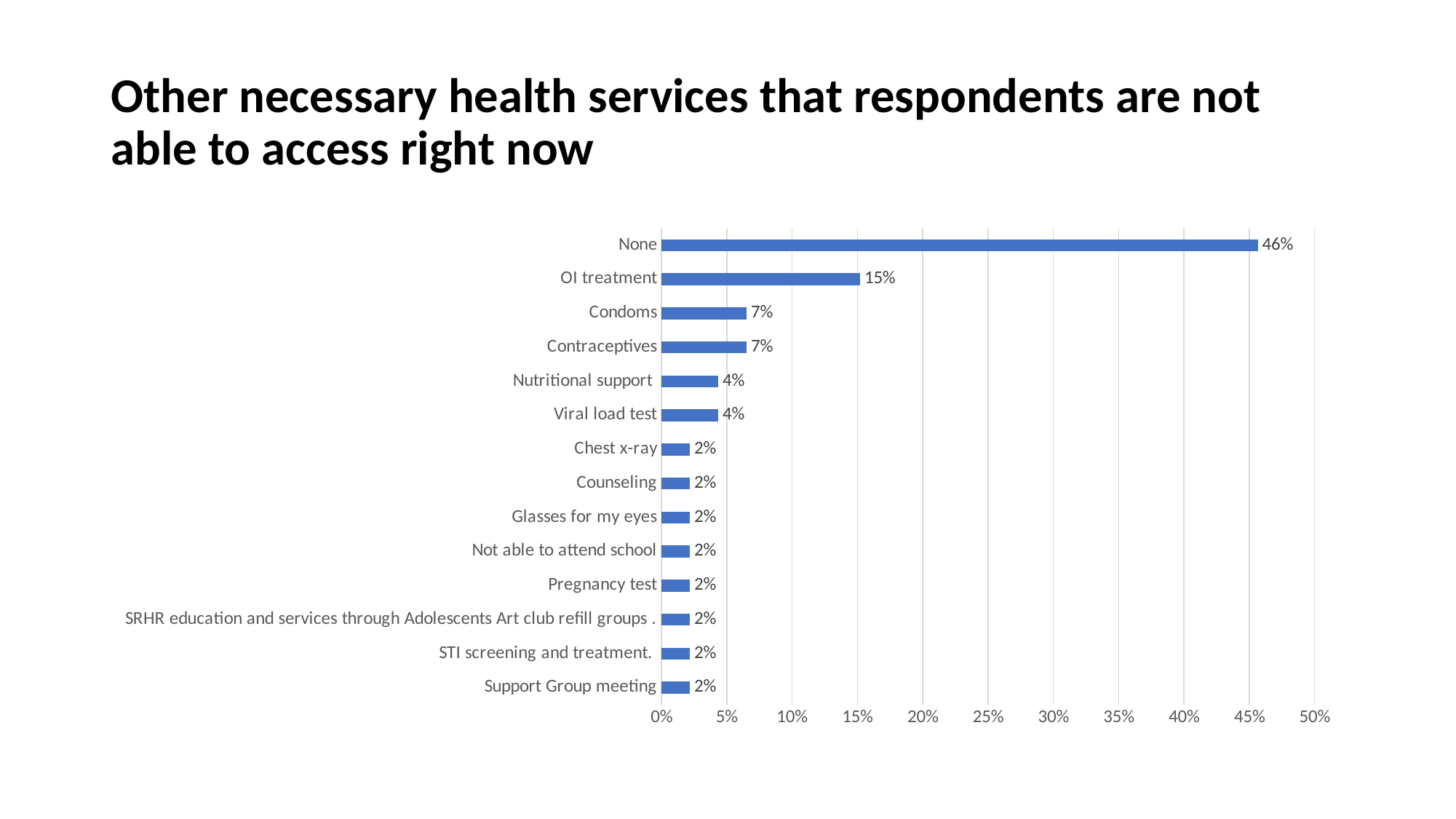
What is the value for OI treatment? 15% Which is larger, the value for Condoms or the value for Viral load test? Condoms What is the value for Chest x-ray? 2% What is the title of the slide? Other necessary health services that respondents are not able to access right now What kind of chart is shown on the slide? Bar chart Which category has the highest value? None Is the value for None greater or less than 40%? greater What is the difference between the values for None and OI treatment? 31% What percentage of respondents answered "None"? 46% What is the value for Nutritional support? 4% How many categories are shown in the chart? 14 What is the difference between the values for OI treatment and Condoms? 8%